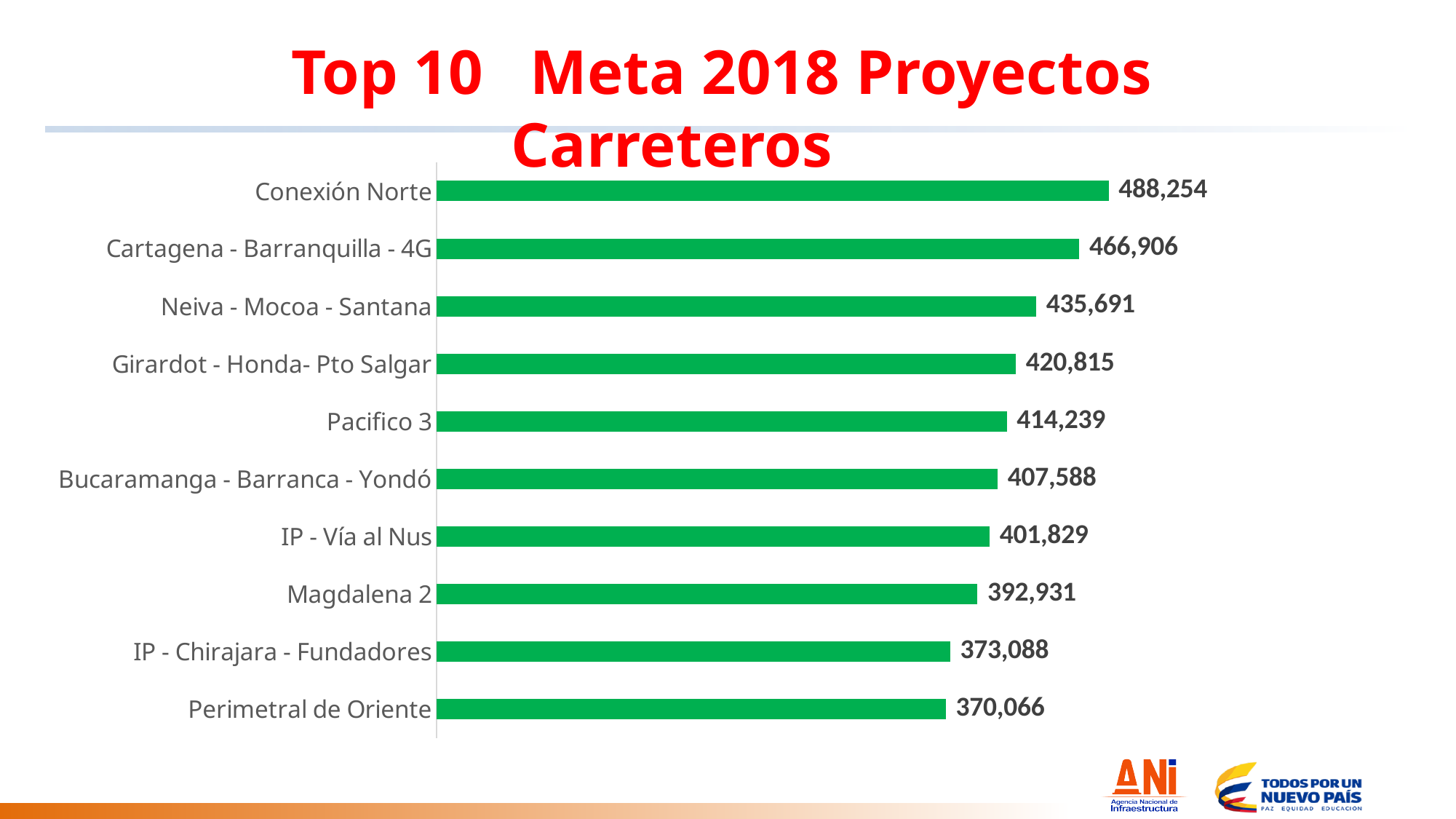
What is the value for Conexión Norte? 488,254 How many projects are shown in the chart? 10 What is the difference between the values for Magdalena 2 and IP - Chirajara - Fundadores? 19,843 What kind of chart is shown on the slide? Bar chart Which is larger, the value for Neiva - Mocoa - Santana or the value for Girardot - Honda- Pto Salgar? Neiva - Mocoa - Santana Which project has the lowest value? Perimetral de Oriente What is the value for Pacifico 3? 414,239 What is the difference between the values for Conexión Norte and Cartagena - Barranquilla - 4G? 21,348 Which project has the highest value? Conexión Norte What is the title of the slide? Top 10 Meta 2018 Proyectos Carreteros What is the value for Perimetral de Oriente? 370,066 What colour are the bars in the chart? Green